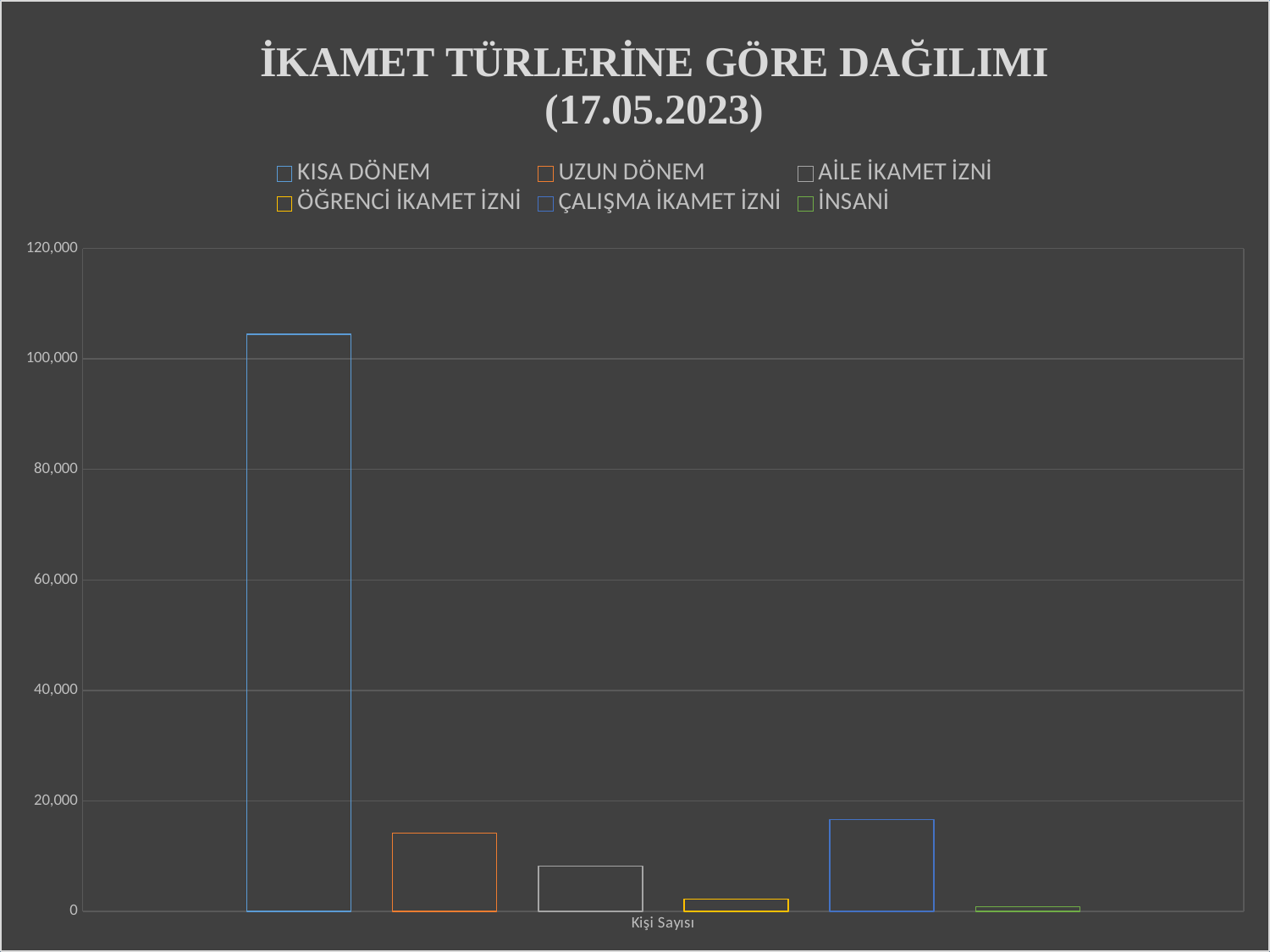
Is the value for AİLE İKAMET İZNİ greater or less than 20,000? less What kind of chart is shown on the slide? bar chart Which is larger, the value for UZUN DÖNEM or the value for ÇALIŞMA İKAMET İZNİ? ÇALIŞMA İKAMET İZNİ Is the value for KISA DÖNEM greater or less than 100,000? greater Is the value for UZUN DÖNEM greater or less than 20,000? less Which is larger, the value for AİLE İKAMET İZNİ or the value for ÖĞRENCİ İKAMET İZNİ? AİLE İKAMET İZNİ How many series does the legend list? 6 Which series has the highest value? KISA DÖNEM What label appears on the horizontal axis of the chart? Kişi Sayısı What is the title of the chart? İKAMET TÜRLERİNE GÖRE DAĞILIMI (17.05.2023) Which series has the lowest value? İNSANİ